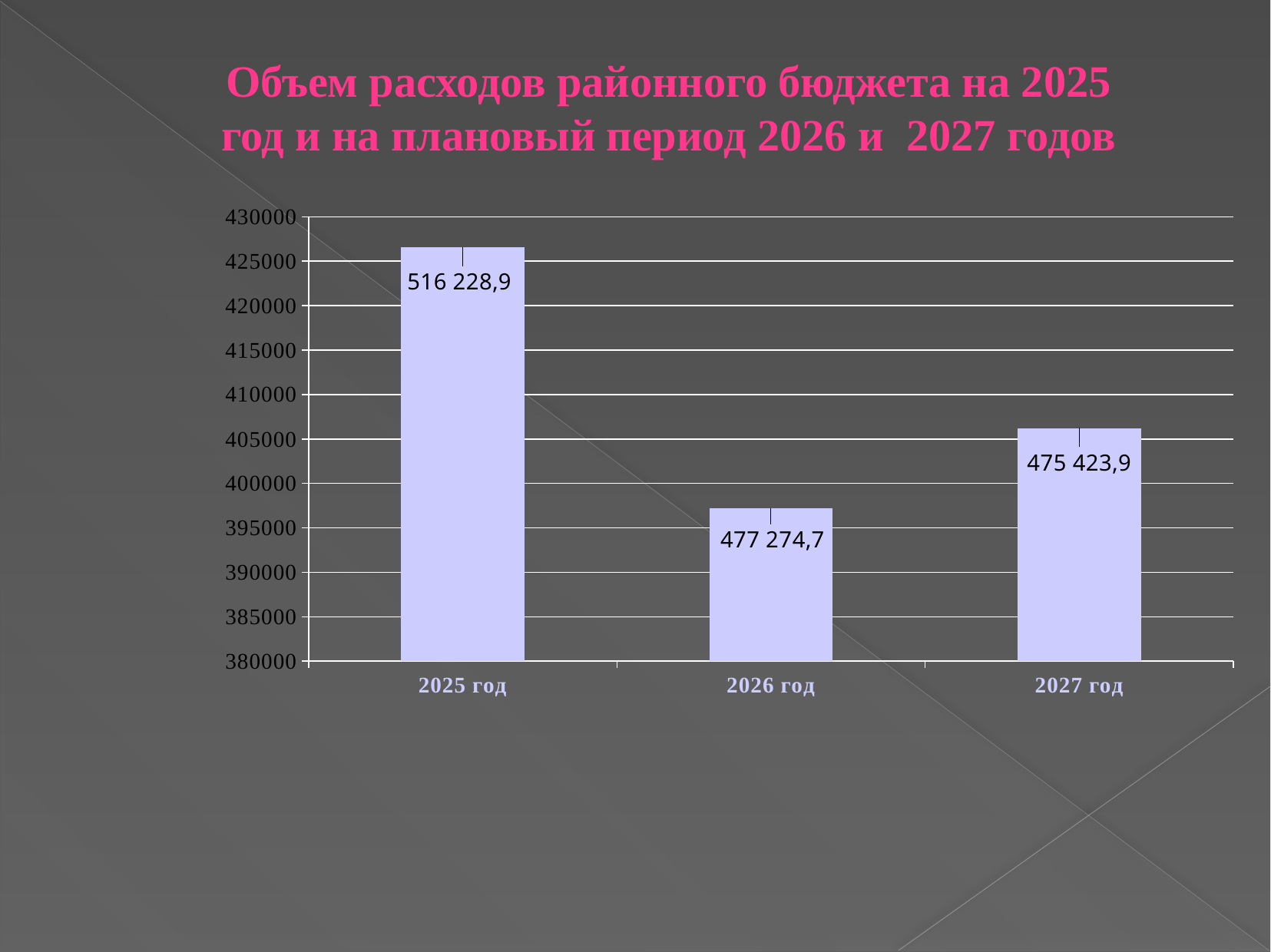
What is the difference between the values for 2025 год and 2026 год? 38 954,2 What is the lowest value shown on the vertical axis? 380000 What kind of chart is shown on the slide? Bar chart Which is larger, the value for 2025 год or the value for 2027 год? 2025 год How many years are shown on the chart? 3 What is the value shown for 2026 год? 477 274,7 What is the title of the slide? Объем расходов районного бюджета на 2025 год и на плановый период 2026 и 2027 годов What is the difference between the values for 2025 год and 2027 год? 40 805,0 What is the value shown for 2025 год? 516 228,9 Which year has the highest value? 2025 год What is the value shown for 2027 год? 475 423,9